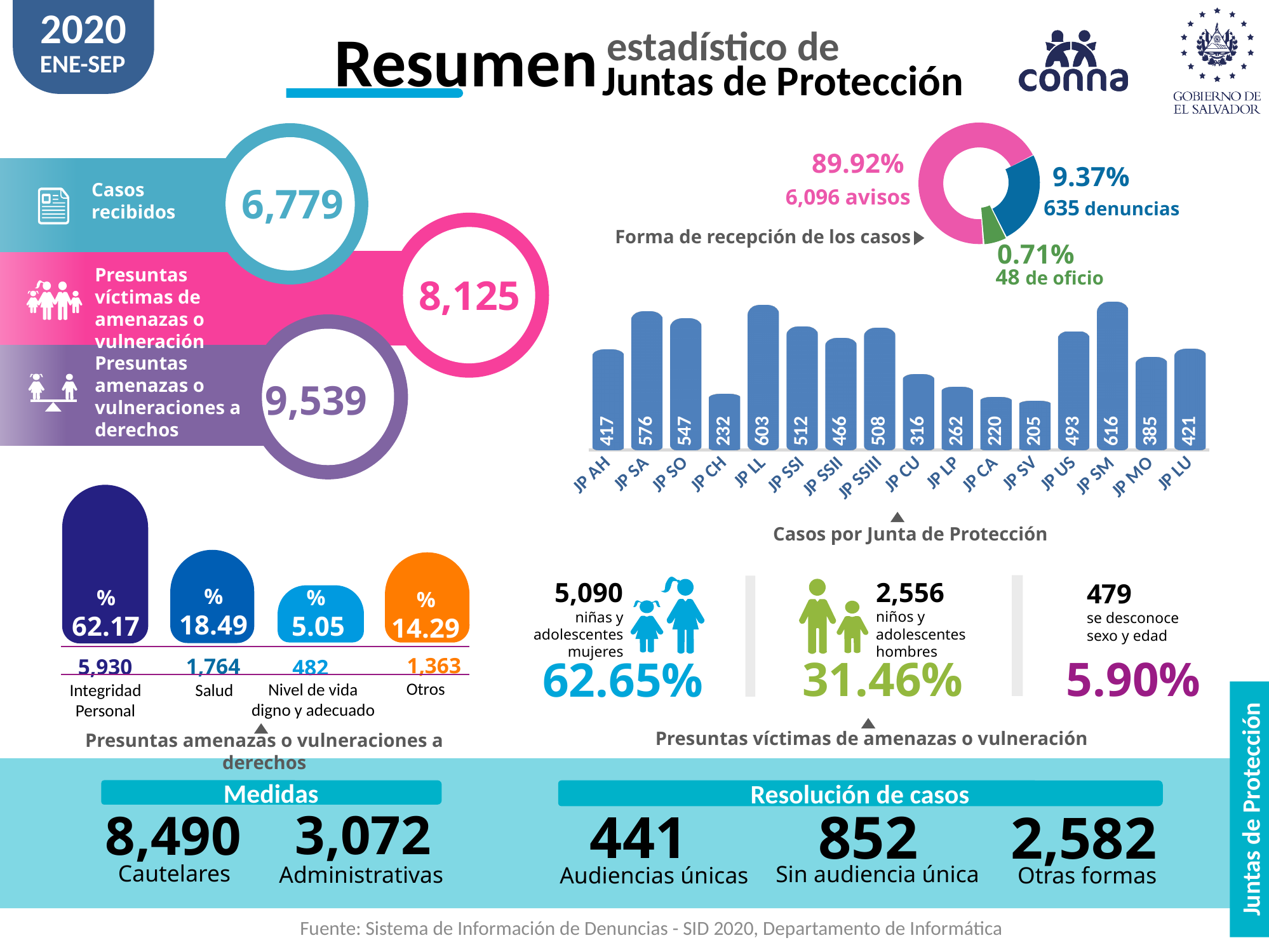
In the 'Casos por Junta de Protección' bar chart, which is larger, JP SO or JP SSI? JP SO In the 'Presuntas amenazas o vulneraciones a derechos' bar chart, which category has the highest value? Integridad Personal In the 'Casos por Junta de Protección' bar chart, how many Juntas are shown? 16 In the 'Casos por Junta de Protección' bar chart, which Junta has the highest number of cases? JP SM In the 'Casos por Junta de Protección' bar chart, which Junta has the lowest number of cases? JP SV In the 'Presuntas amenazas o vulneraciones a derechos' bar chart, what percentage is shown for Otros? 14.29% In the 'Casos por Junta de Protección' bar chart, what is the difference between JP SA and JP CH? 344 What kind of chart is 'Casos por Junta de Protección'? Bar chart In the 'Casos por Junta de Protección' bar chart, what is the value for JP LL? 603 In the 'Presuntas amenazas o vulneraciones a derechos' bar chart, what is the value for Salud? 1,764 In the 'Forma de recepción de los casos' donut chart, what share of cases were received as avisos? 89.92% In the 'Forma de recepción de los casos' donut chart, how many cases were received de oficio? 48